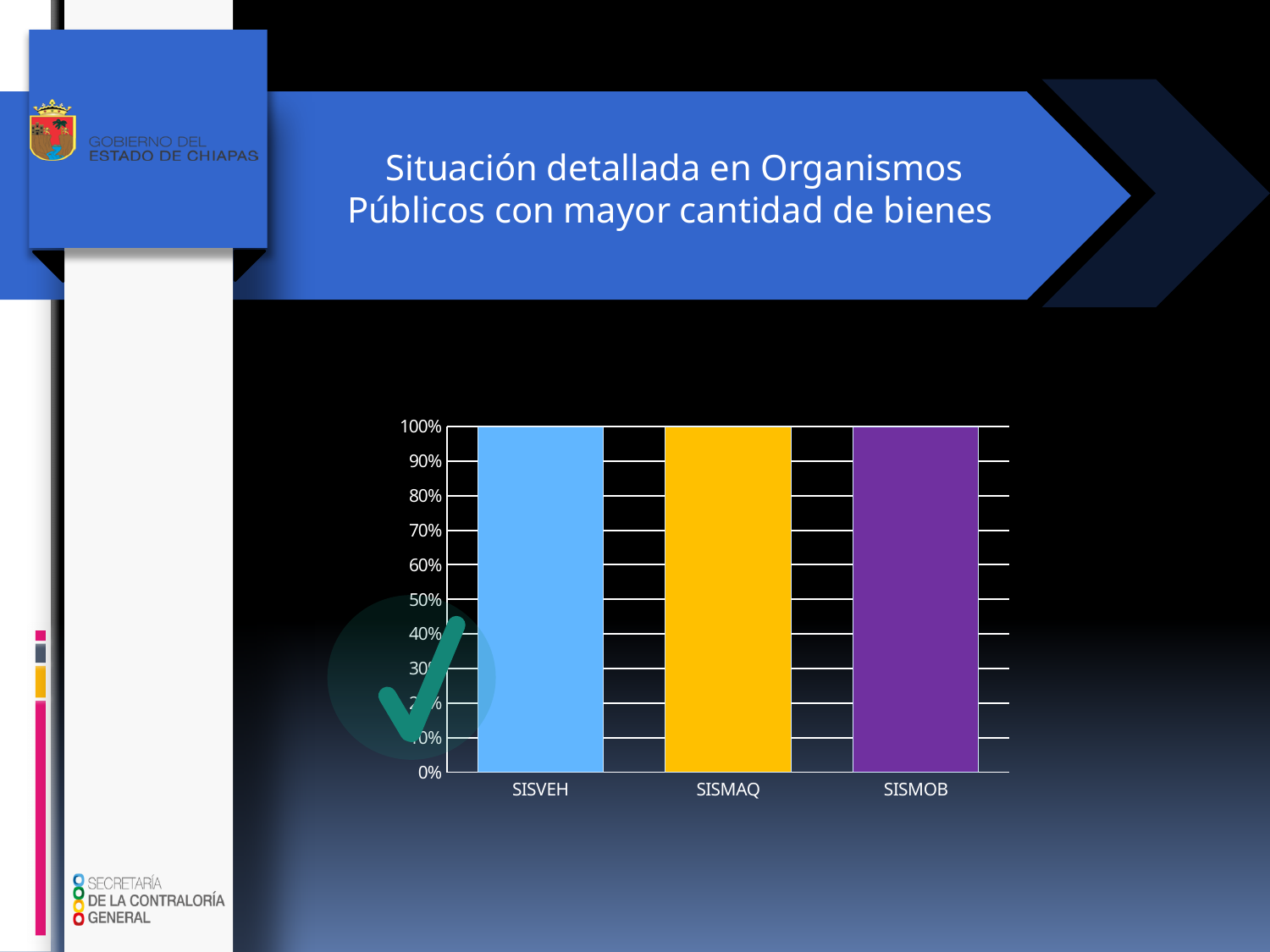
Is the value for SISMOB greater or less than 90%? greater How many categories are shown on the x axis of the chart? 3 What is the value for SISMAQ? 100% What is the value for SISVEH? 100% Do the values rise, fall, or stay the same across the categories from SISVEH to SISMOB? stay the same What colour is the bar for SISMAQ? yellow What is the value for SISMOB? 100% Is the value for SISVEH greater or less than 50%? greater What is the highest value shown on the y axis of the chart? 100% What kind of chart is shown on the slide? bar chart What is the difference between the values for SISMAQ and SISVEH? 0%